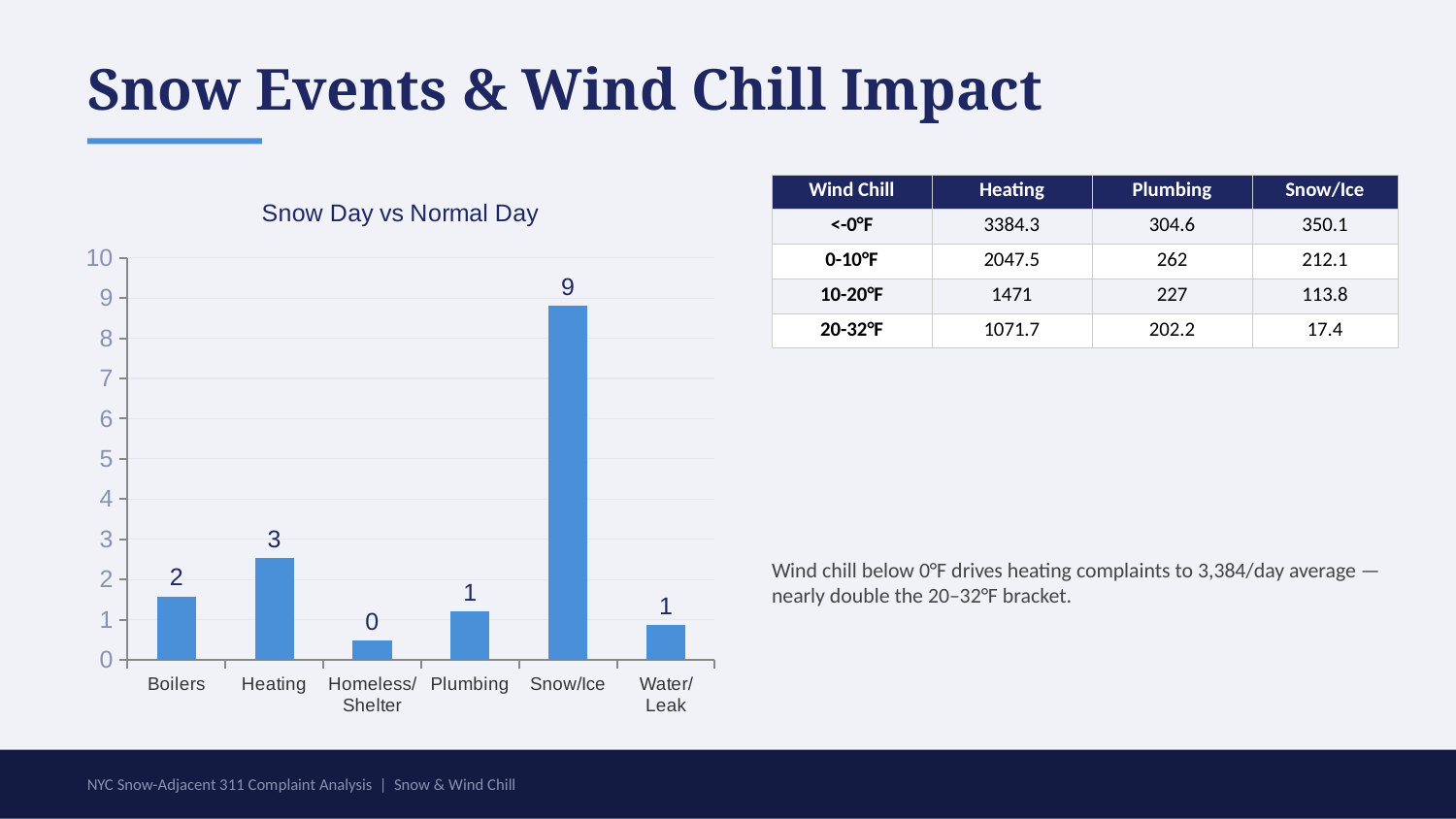
What is the data label shown for Snow/Ice in the Snow Day vs Normal Day chart? 9 What is the data label shown for Homeless/Shelter in the Snow Day vs Normal Day chart? 0 Which category has the lowest value in the Snow Day vs Normal Day chart? Homeless/Shelter Which category has the highest value in the Snow Day vs Normal Day chart? Snow/Ice How many categories are shown on the x axis of the Snow Day vs Normal Day chart? 6 In the Snow Day vs Normal Day chart, which is larger, the bar for Boilers or the bar for Heating? Heating What is the data label shown for Boilers in the Snow Day vs Normal Day chart? 2 What is the data label shown for Heating in the Snow Day vs Normal Day chart? 3 What is the title of the chart on the slide? Snow Day vs Normal Day What kind of chart is shown on the slide? Bar chart Using the data labels, what is the difference between the Snow/Ice value and the Heating value in the Snow Day vs Normal Day chart? 6 Is the value for Snow/Ice in the Snow Day vs Normal Day chart greater or less than 8? greater